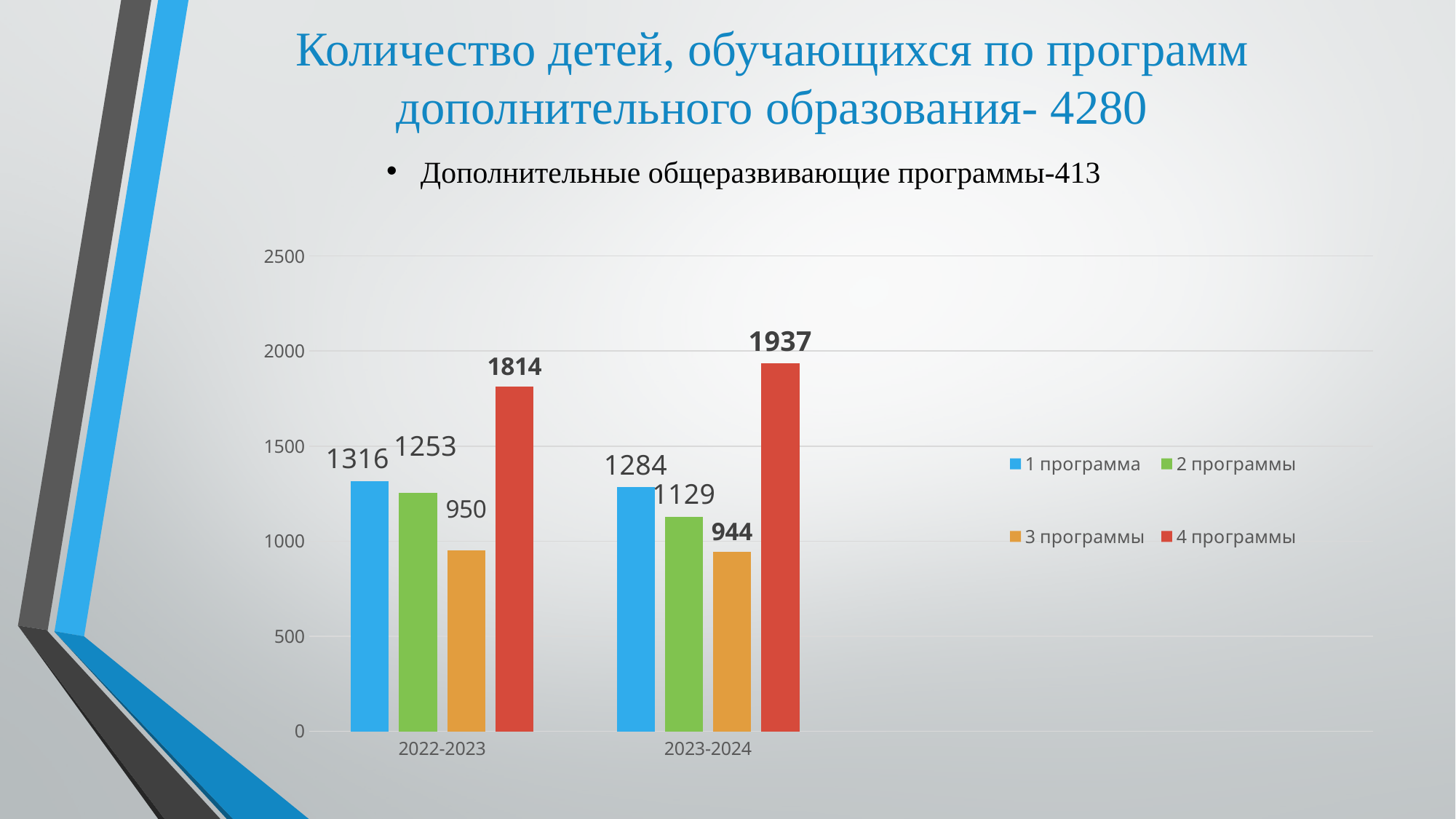
What kind of chart is shown on the slide? Bar chart What is the value for "1 программа" in 2022-2023? 1316 What is the value for "2 программы" in 2023-2024? 1129 Which series has the highest value in 2023-2024? 4 программы Which is larger: "2 программы" in 2022-2023 or "2 программы" in 2023-2024? 2022-2023 How many categories are shown on the x axis? 2 Which series has the lowest value in 2022-2023? 3 программы What is the difference between the "4 программы" values for 2023-2024 and 2022-2023? 123 What is the value for "4 программы" in 2023-2024? 1937 How many series does the legend list? 4 Which colour represents "3 программы" in the legend? Orange What is the value for "3 программы" in 2022-2023? 950